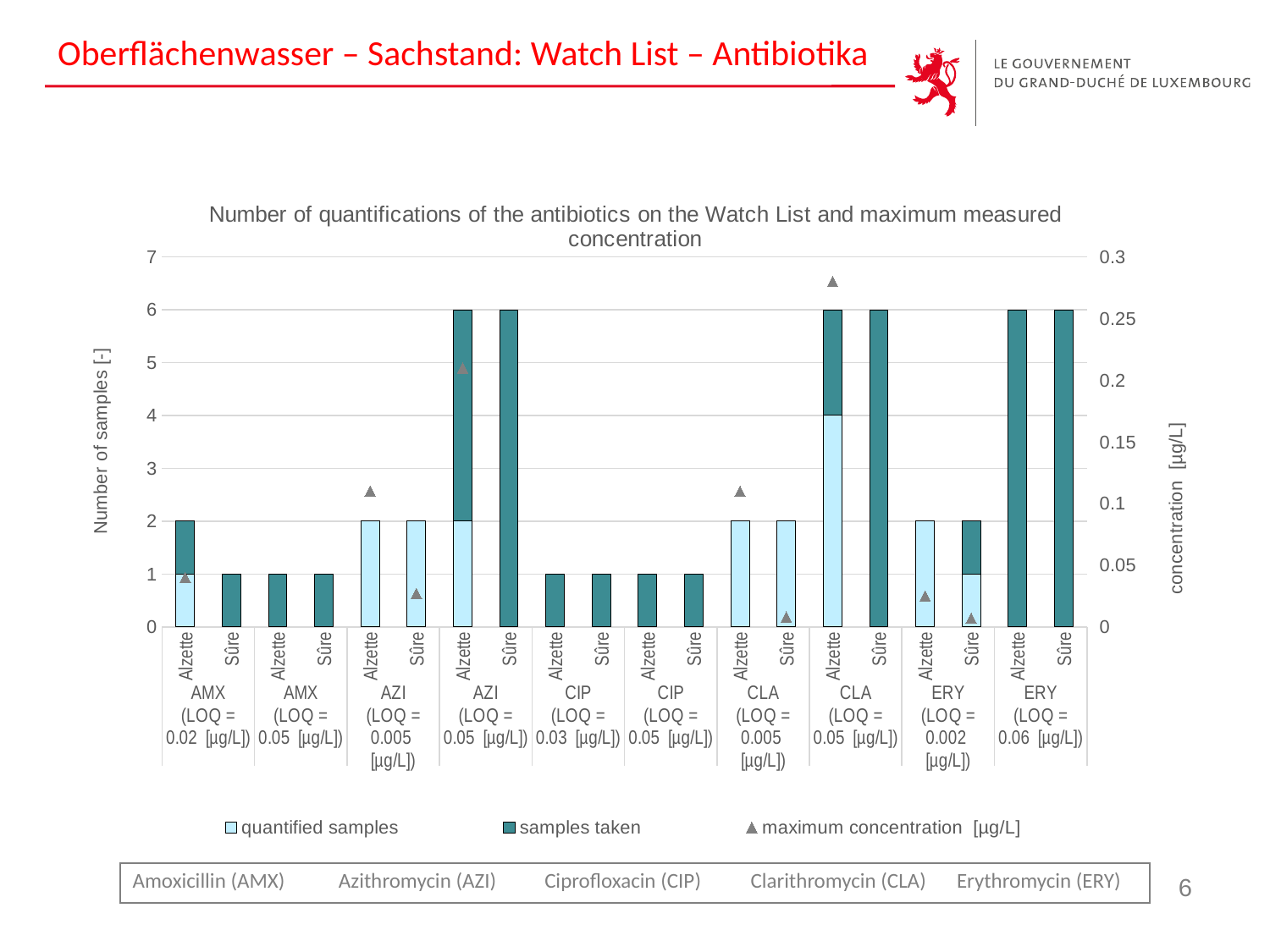
How many bars (river/antibiotic combinations) are plotted along the x axis? 20 Is the maximum concentration for CLA (LOQ = 0.05 µg/L) in the Alzette greater or less than 0.25 µg/L? greater How many quantified samples are shown for CLA (LOQ = 0.05 µg/L) in the Alzette? 4 What is the difference between samples taken and quantified samples for CLA (LOQ = 0.05 µg/L) in the Alzette? 2 What is the label of the right-hand vertical axis? concentration [µg/L] Is the maximum concentration for AZI (LOQ = 0.05 µg/L) in the Alzette greater or less than 0.15 µg/L? greater Which has more samples taken: ERY (LOQ = 0.06 µg/L) in the Sûre or ERY (LOQ = 0.002 µg/L) in the Sûre? ERY (LOQ = 0.06 µg/L) in the Sûre How many samples were taken for AZI (LOQ = 0.05 µg/L) in the Alzette? 4 How many series does the legend list? 3 How many quantified samples are shown for AMX (LOQ = 0.02 µg/L) in the Alzette? 1 How many samples were taken for AMX (LOQ = 0.02 µg/L) in the Sûre? 1 What kind of chart is shown on the slide? bar chart